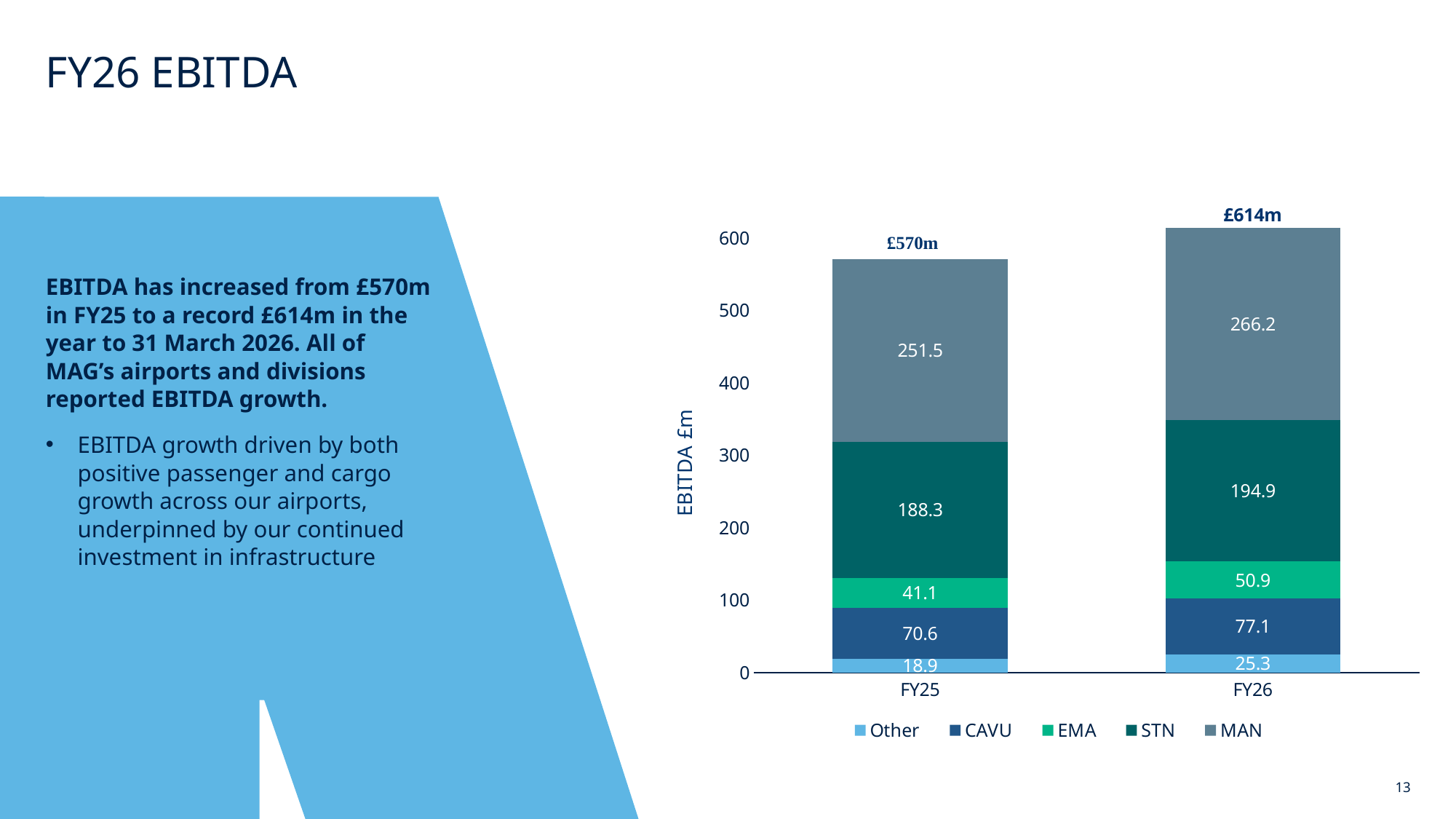
What is the MAN value for FY26? 266.2 What is the STN value for FY25? 188.3 What is the total EBITDA shown for the FY25 bar? £570m Which series has the smallest segment in the FY25 bar? Other What is the total EBITDA shown for the FY26 bar? £614m Which is larger, the CAVU value in FY25 or the CAVU value in FY26? FY26 What is the EMA value for FY26? 50.9 Which series has the largest segment in the FY26 bar? MAN What type of chart is shown on the slide? Stacked bar chart How many series does the legend list? 5 What is the CAVU value for FY25? 70.6 By how much did the MAN value increase from FY25 to FY26? 14.7